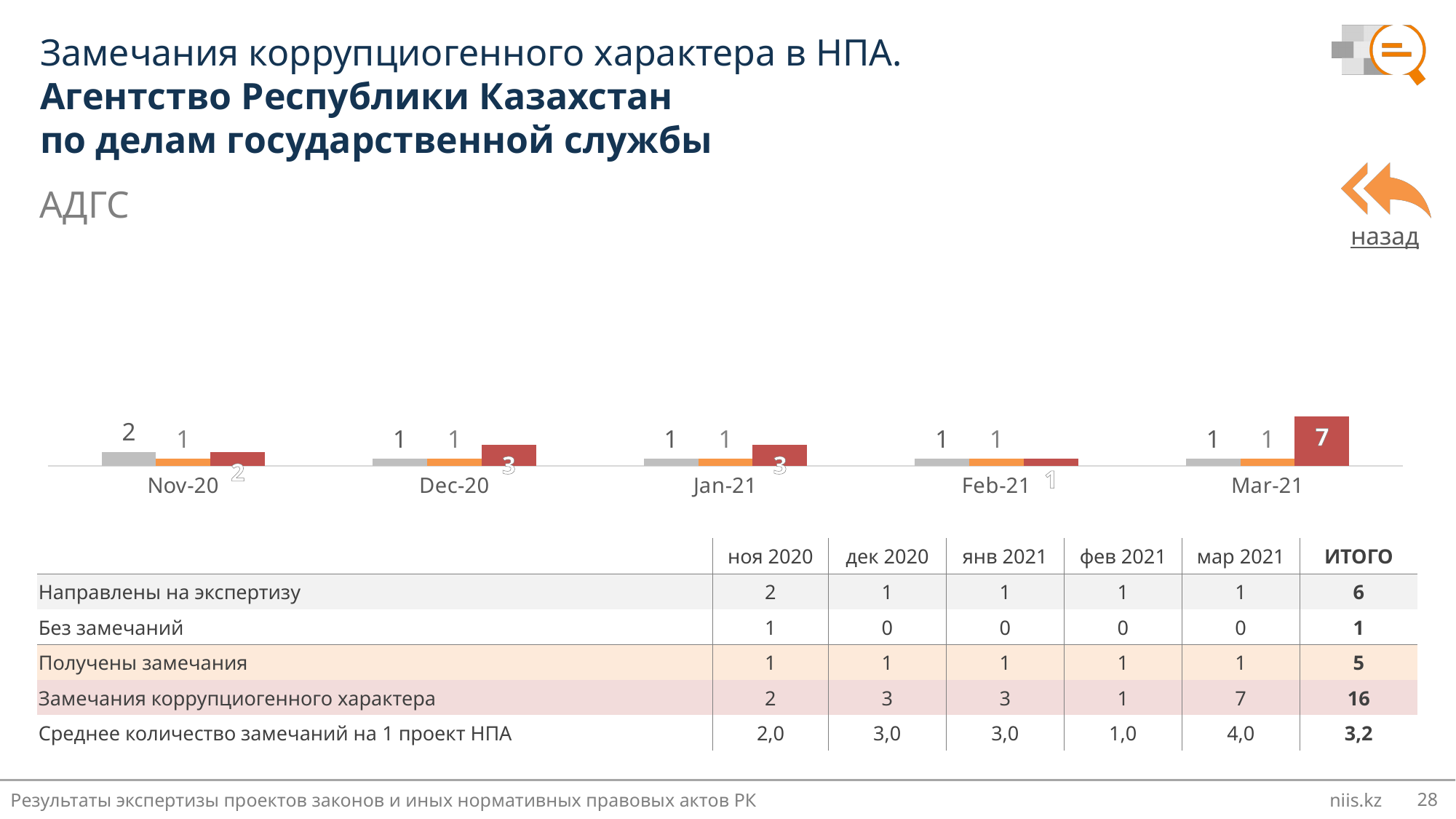
What is the difference between the red bar values for Mar-21 and Feb-21? 6 What type of chart is shown on the slide? bar chart What is the value of the gray bar for Nov-20? 2 What is the first month shown on the x axis of the chart? Nov-20 What is the value of the red bar for Feb-21? 1 How many months (categories) are shown on the x axis of the chart? 5 What is the value of the orange bar for Jan-21? 1 In which month is the red bar highest? Mar-21 What is the value of the red bar for Dec-20? 3 What is the value of the red bar for Mar-21? 7 In which month is the red bar lowest? Feb-21 Which is larger: the red bar for Jan-21 or the red bar for Nov-20? Jan-21